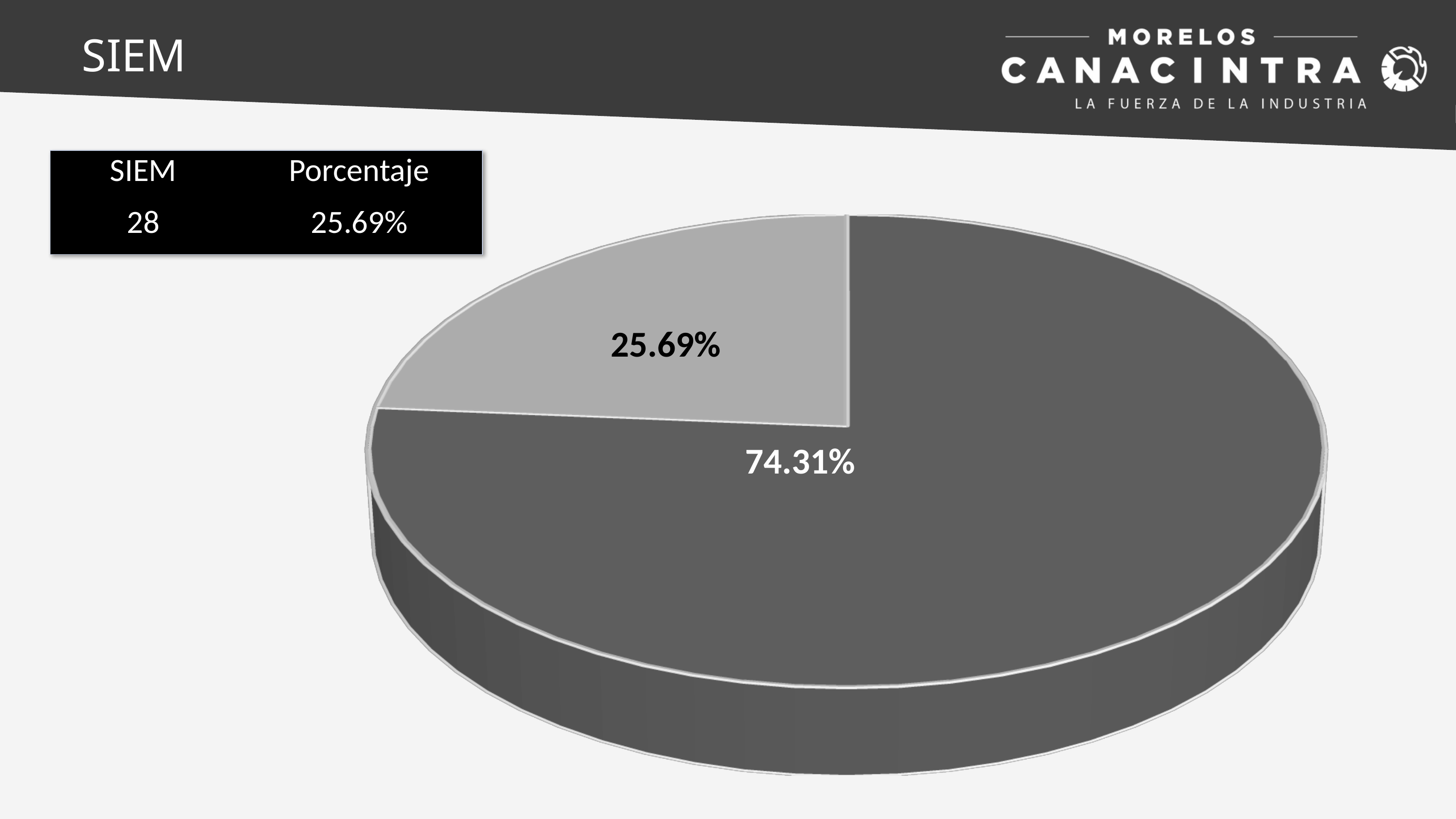
How many slices does the pie chart have? 2 What share of the pie does the lighter grey slice represent? 25.69% Which slice is larger, the lighter grey one or the darker grey one? the darker grey one What percentage is shown on the darker grey slice of the pie chart? 74.31% What is the value of the smallest slice in the pie chart? 25.69% What is the title of the slide containing the pie chart? SIEM What is the value of the largest slice in the pie chart? 74.31% What kind of chart is shown on the slide? pie chart What is the difference between the two slice values in the pie chart? 48.62% Is the value of the lighter grey slice greater or less than 50%? less What percentage is shown on the lighter grey slice of the pie chart? 25.69% Does the pie chart display a legend? No